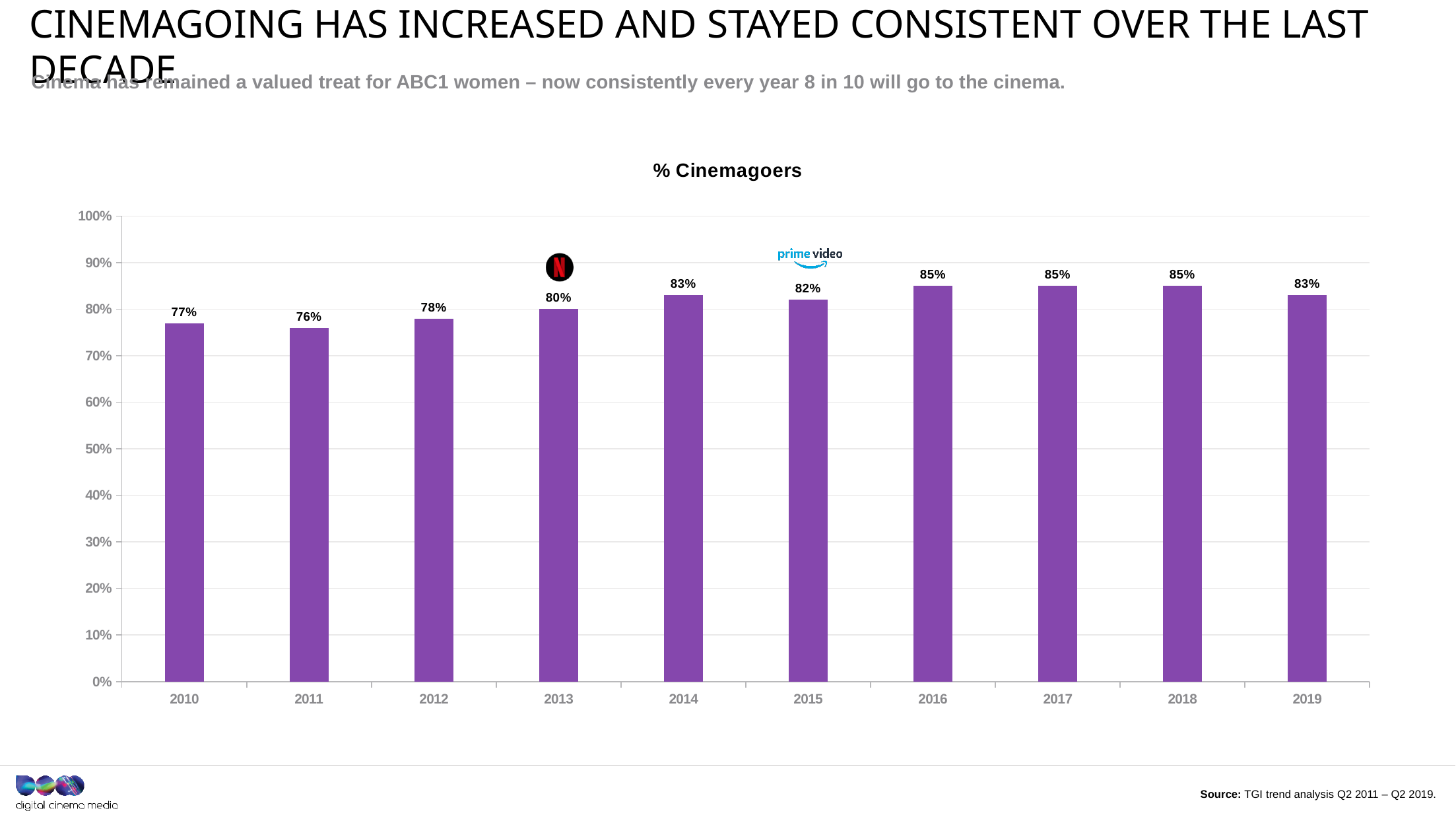
Which year has the lowest value? 2011 What kind of chart is this? bar chart What is the value for 2010? 77% Is the value for 2012 greater or less than 70%? greater Which is larger, the value for 2013 or the value for 2014? 2014 What is the difference between the values for 2016 and 2010? 8% What is the highest value shown on the chart? 85% What is the value for 2015? 82% What is the value for 2019? 83% Do the values generally rise or fall from 2010 to 2018? rise How many years are shown on the x axis? 10 What is the title of the chart? % Cinemagoers